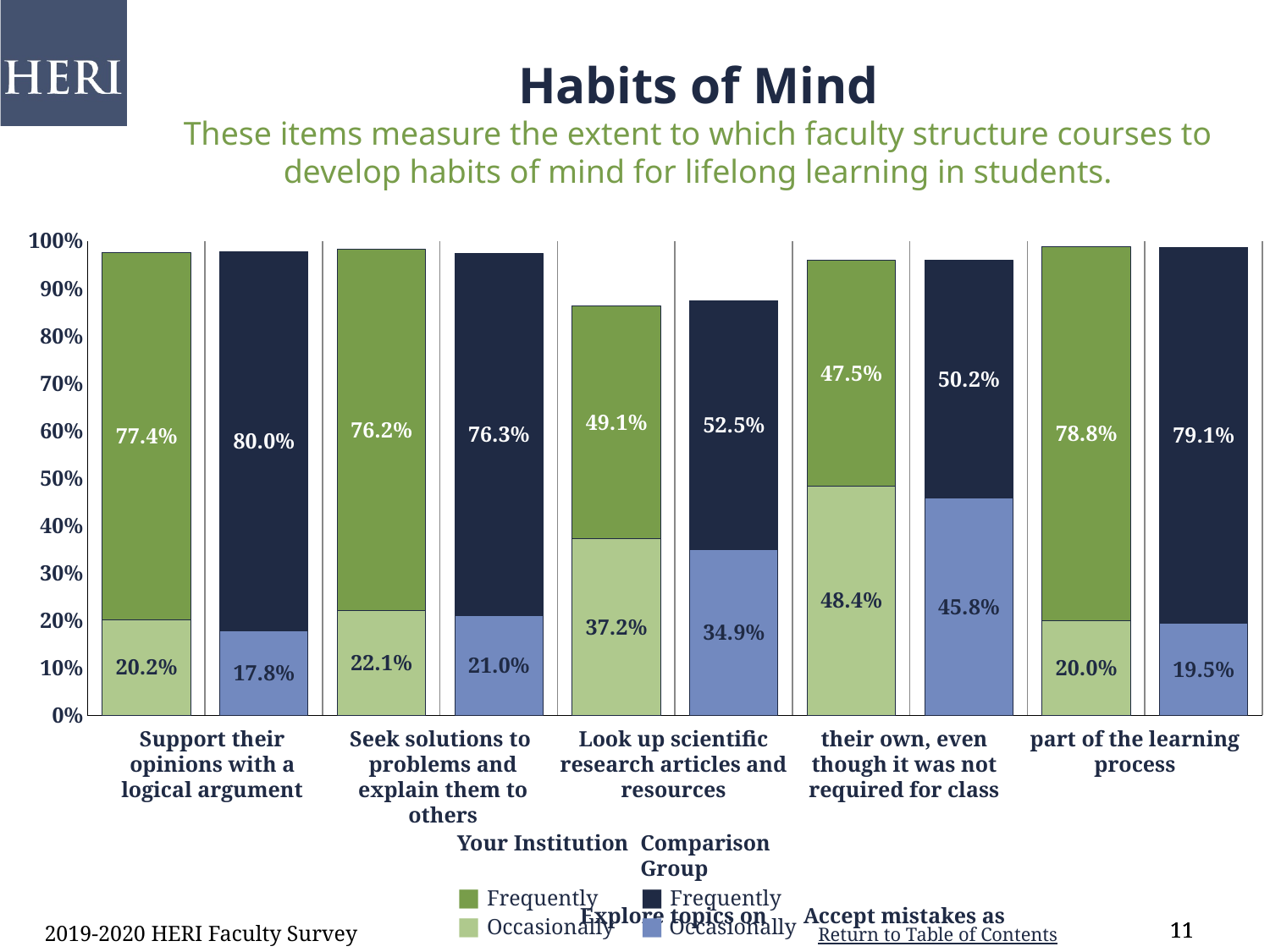
How many categories (habits of mind items) are shown on the x axis? 5 For 'Look up scientific research articles and resources', which is larger: the Your Institution 'Frequently' value or the Comparison Group 'Frequently' value? Comparison Group How many entries does the legend list? 4 What percentage of Your Institution faculty report 'Frequently' for 'Support their opinions with a logical argument'? 77.4% What is the Your Institution 'Occasionally' value for 'Look up scientific research articles and resources'? 37.2% Among the Comparison Group bars, which category has the highest 'Frequently' percentage? Support their opinions with a logical argument What type of chart is shown on the slide? Stacked bar chart What is the difference between the Comparison Group and Your Institution 'Frequently' values for 'Support their opinions with a logical argument'? 2.6% What is the combined 'Frequently' plus 'Occasionally' total for the Your Institution bar for 'Look up scientific research articles and resources'? 86.3% Among the Your Institution bars, which category has the lowest 'Frequently' percentage? Explore topics on their own, even though it was not required for class What is the Comparison Group 'Frequently' value for 'Look up scientific research articles and resources'? 52.5% What is the Comparison Group 'Occasionally' value for 'Seek solutions to problems and explain them to others'? 21.0%